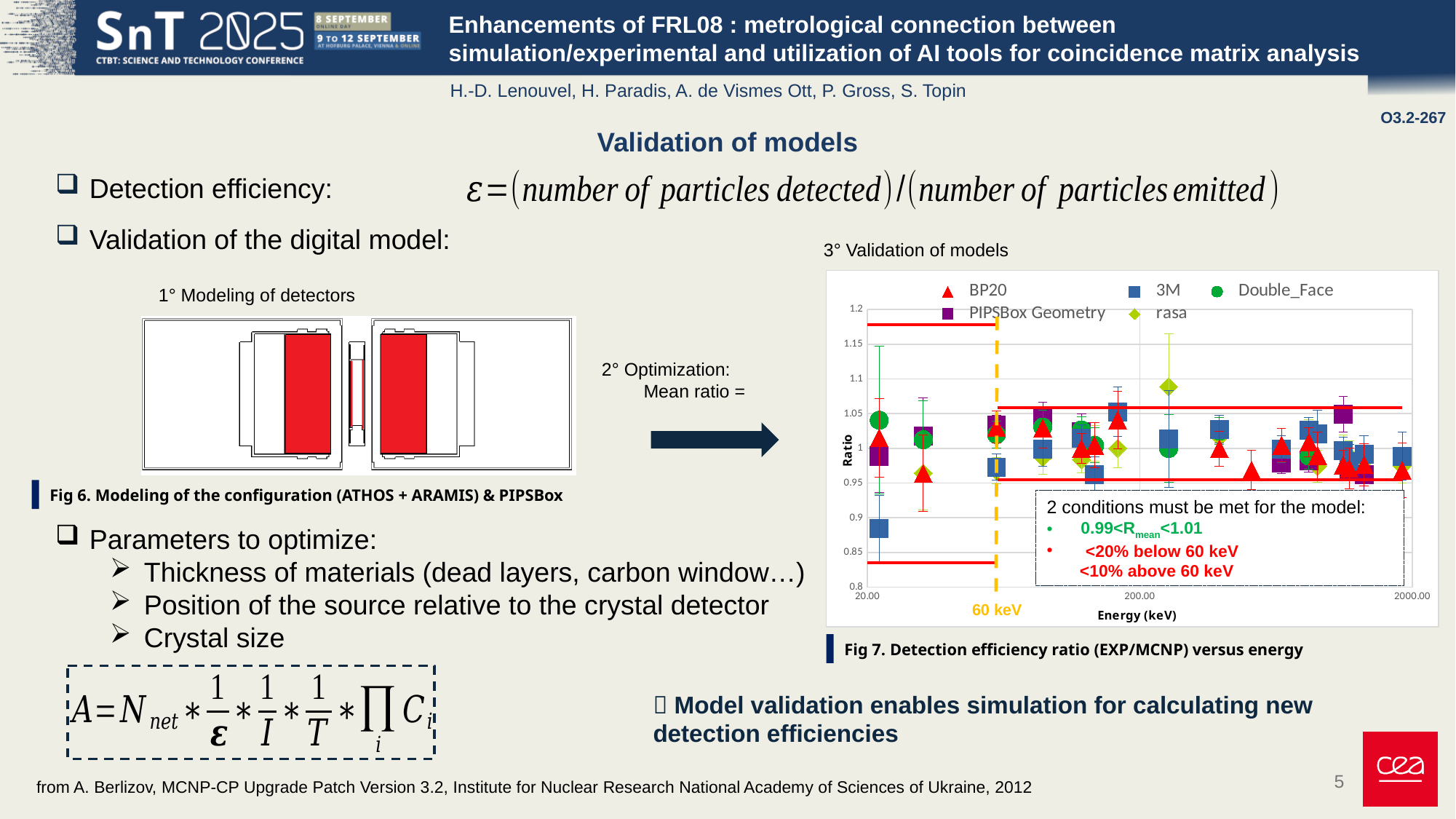
What kind of chart is Fig 7 (Detection efficiency ratio versus energy)? scatter chart In the Fig 7 chart, is the 3M point at the lowest energy (near 20 keV) greater or less than 0.95? less How many series does the legend of the Fig 7 chart list? 5 Which series has the single lowest plotted ratio in the Fig 7 chart? 3M What energy does the dashed vertical line in the Fig 7 chart mark? 60 keV In the Fig 7 chart, is the BP20 point at the highest energy (near 2000 keV) greater or less than 1? less In the Fig 7 chart, is the Double_Face point at the lowest energy (near 20 keV) greater or less than 1? greater Which series has the single highest plotted ratio in the Fig 7 chart? rasa What is the label of the y axis of the Fig 7 chart? Ratio